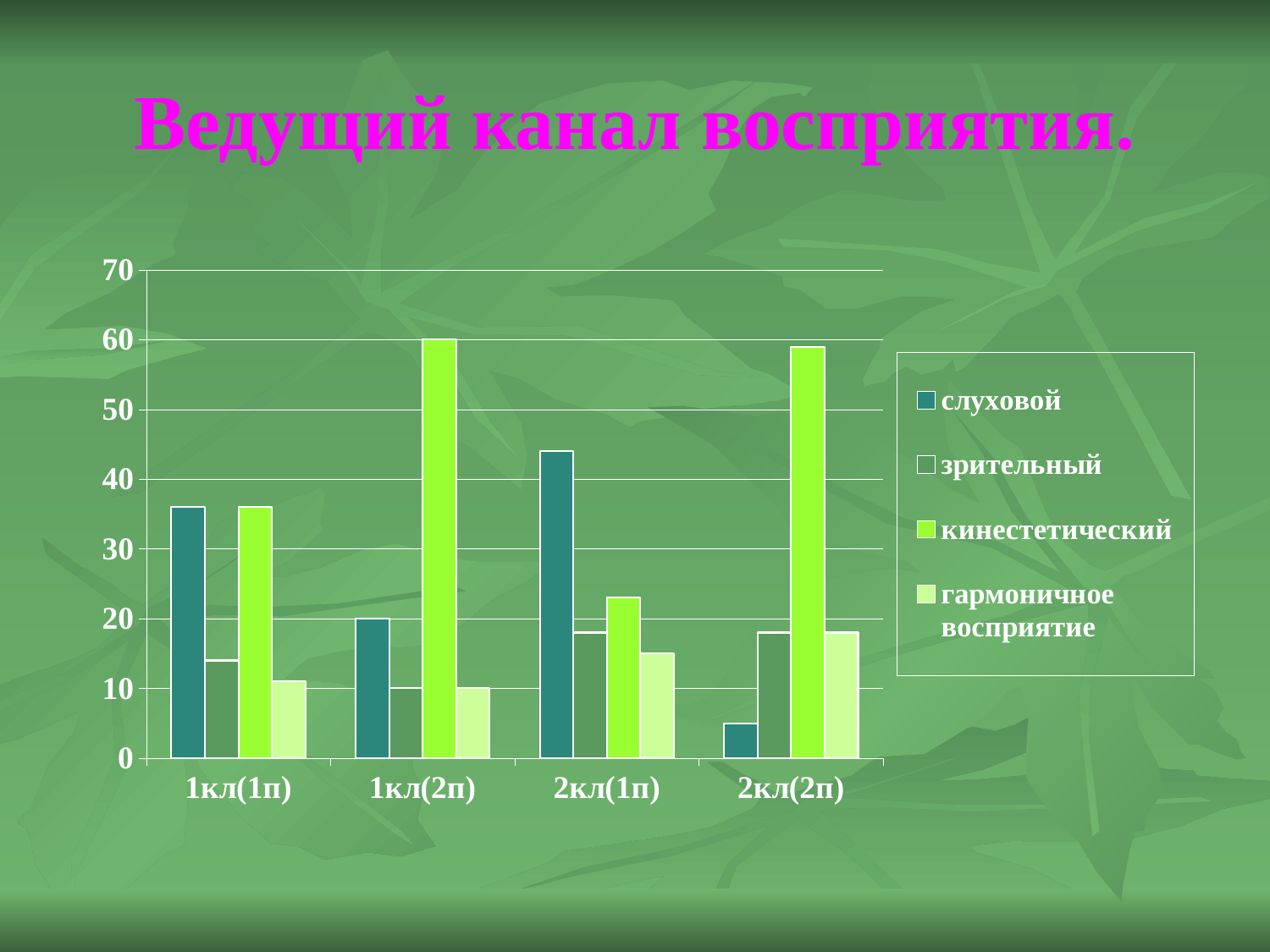
Is the value for слуховой in 2кл(1п) greater or less than 40? greater Which series has the highest bar for 2кл(1п)? слуховой Which series has the lowest bar for 2кл(2п)? слуховой What is the title of the slide above the chart? Ведущий канал восприятия. Is the value for кинестетический in 2кл(2п) greater or less than 50? greater Which is larger: the кинестетический value for 1кл(1п) or for 2кл(1п)? 1кл(1п) What kind of chart is shown on the slide? bar chart Which is larger: the слуховой value for 1кл(1п) or for 1кл(2п)? 1кл(1п) Is the value for слуховой in 2кл(2п) greater or less than 10? less How many series does the legend list? 4 Which series has the highest bar for 1кл(2п)? кинестетический How many categories are shown on the x axis? 4